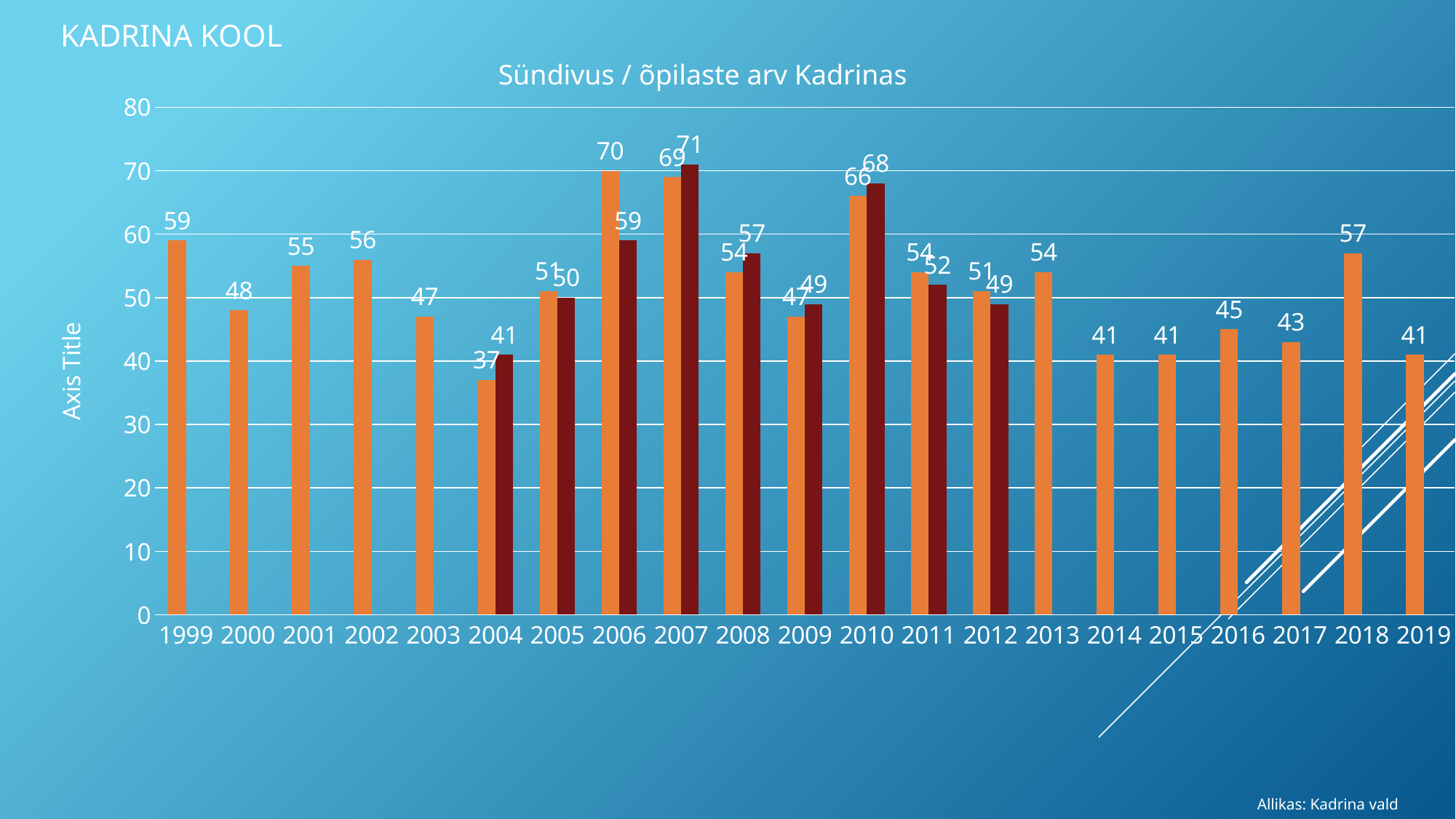
What is the value of the orange bar for 2018? 57 What is the value of the orange bar for 2006? 70 What is the value of the dark red bar for 2007? 71 What is the difference between the orange bar for 1999 and the orange bar for 2000? 11 What is the title of the chart? Sündivus / õpilaste arv Kadrinas What is the difference between the dark red bar and the orange bar for 2010? 2 Which is larger, the orange bar for 2016 or the orange bar for 2017? 2016 Which year has the lowest orange bar? 2004 How many years are shown on the x axis? 21 Which year has the highest orange bar? 2006 What type of chart is shown on the slide? Bar chart Which year has the highest dark red bar? 2007